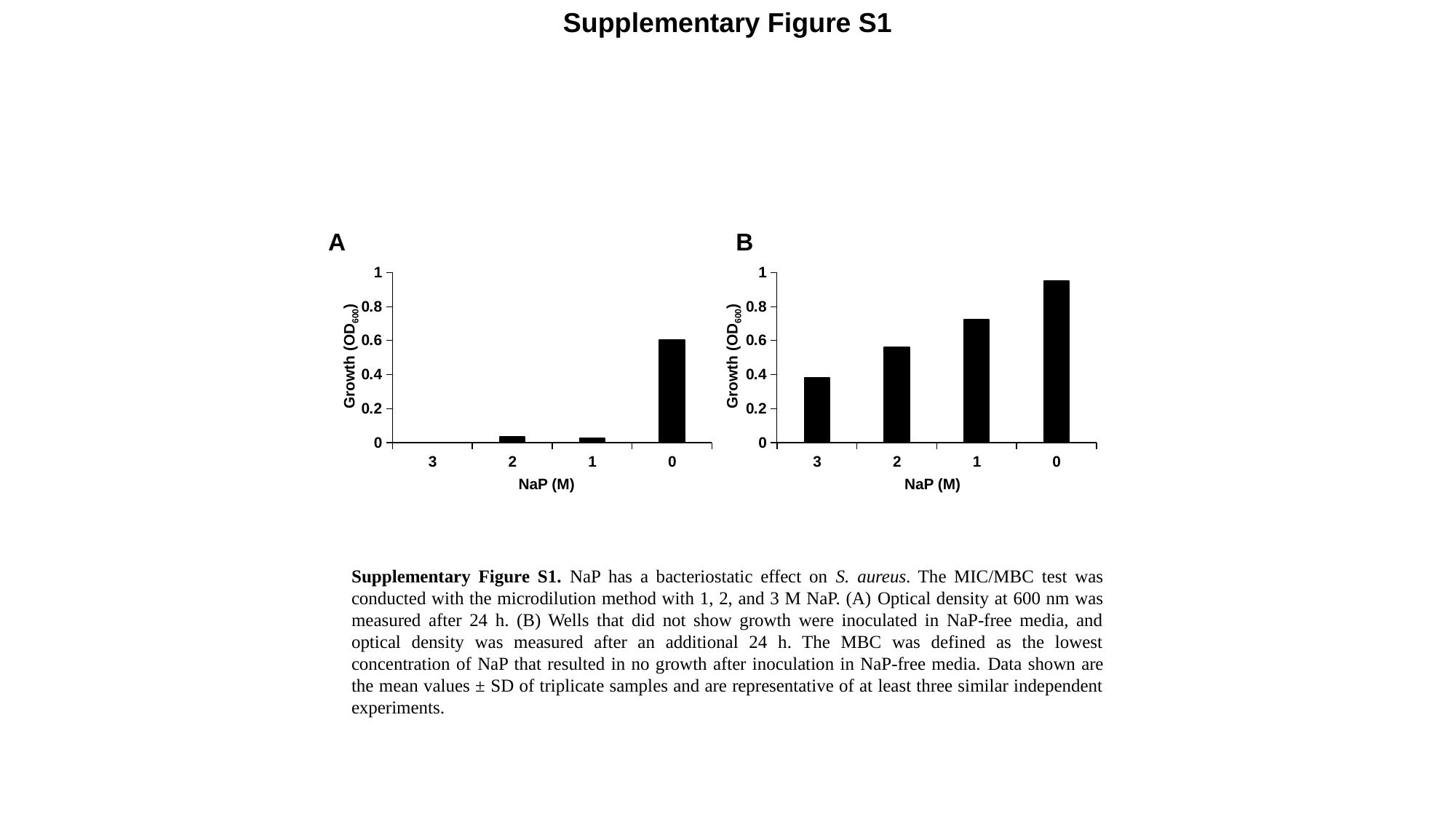
In chart A, which NaP concentration has the highest growth? 0 In chart B, which NaP concentration has the lowest growth? 3 In chart B, is the growth value for 0 M NaP greater or less than 0.8? greater In chart A, is the growth value for 2 M NaP greater or less than 0.2? less In chart B, which NaP concentration has the highest growth? 0 In chart B, is the growth value for 3 M NaP greater or less than 0.2? greater What kind of chart is chart A? bar chart How many NaP concentrations are shown on the x axis of chart B? 4 What is the x-axis title of chart A? NaP (M) In chart B, which has higher growth: 1 M NaP or 2 M NaP? 1 M NaP In chart B, do the growth values rise or fall moving from left to right along the x axis? rise